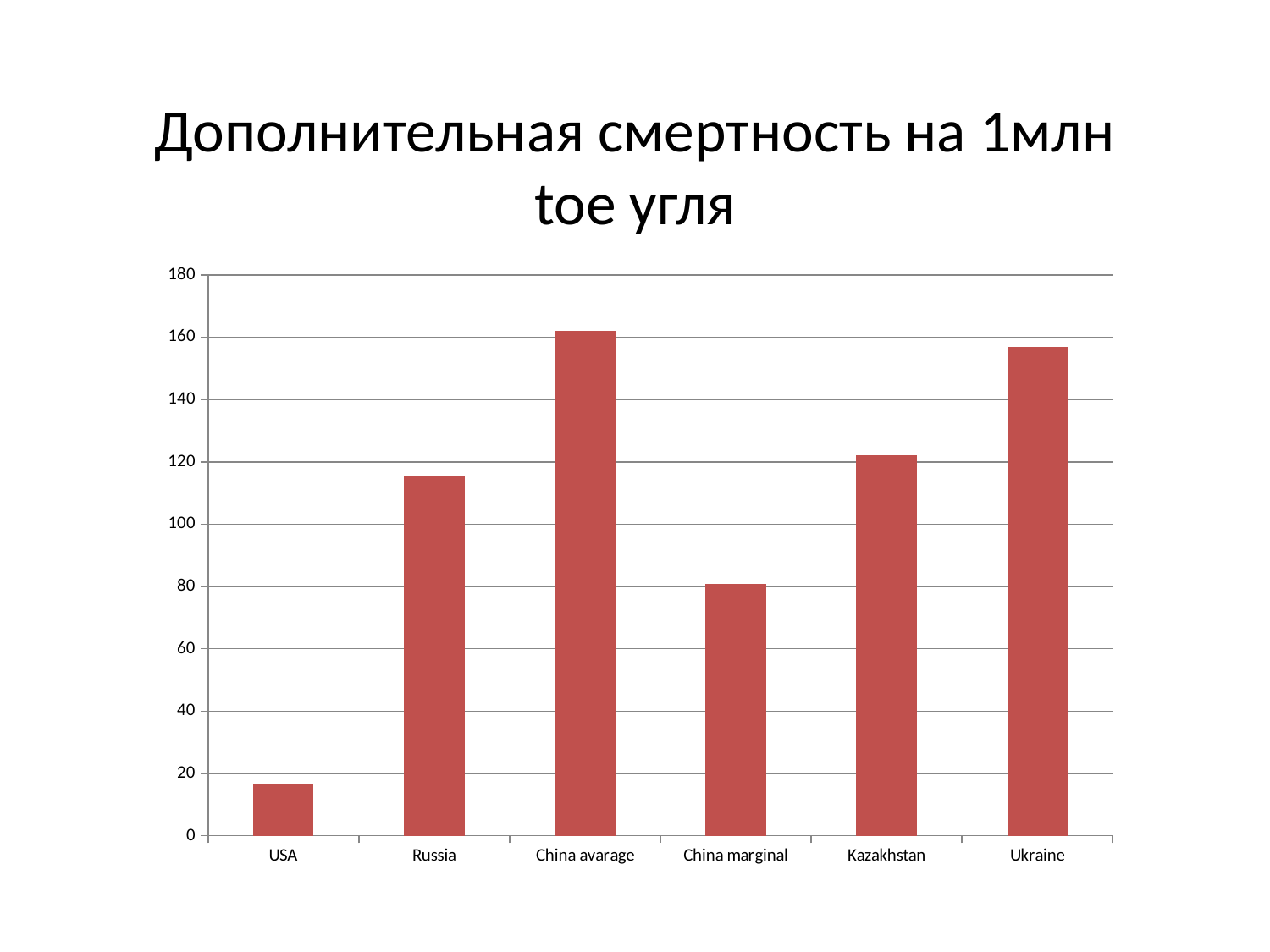
Which is larger, the value for Russia or the value for China marginal? Russia How many categories are shown on the x axis of the chart? 6 Is the value for Kazakhstan greater or less than 100? greater Which category has the highest bar in the chart? China avarage Is the value for China marginal greater or less than 100? less What is the title of the chart on the slide? Дополнительная смертность на 1млн toe угля Which category has the lowest bar in the chart? USA Is the value for Russia greater or less than 100? greater What kind of chart is shown on the slide? bar chart Which is larger, the value for Kazakhstan or the value for Russia? Kazakhstan